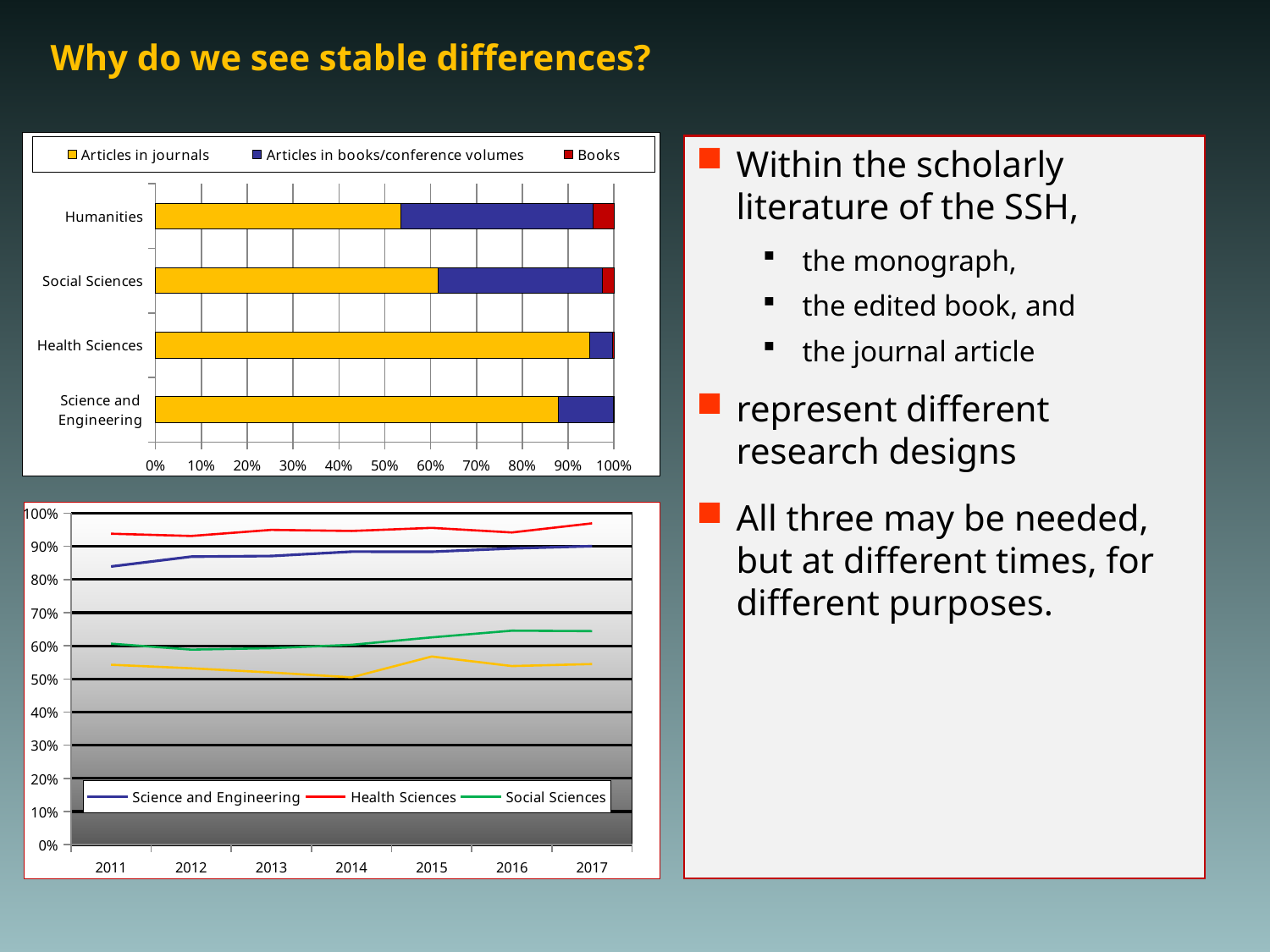
In the top chart, which category has the largest share of Articles in journals? Health Sciences In the top chart, which category has the smallest share of Articles in journals? Humanities In the bottom chart, which series has the highest values across all years? Health Sciences What kind of chart is the bottom chart on the slide? line chart How many series does the legend of the bottom chart list? 3 In the bottom chart, does the Science and Engineering line rise or fall from 2011 to 2017? rise What kind of chart is the top chart on the slide? stacked bar chart In the top chart, which category has the largest Books share, Humanities or Health Sciences? Humanities In the top chart, is the share of Articles in journals for Humanities greater or less than 60%? less How many series does the legend of the top chart list? 3 In the top chart, is the share of Articles in journals for Science and Engineering greater or less than 80%? greater How many categories are shown on the top chart? 4